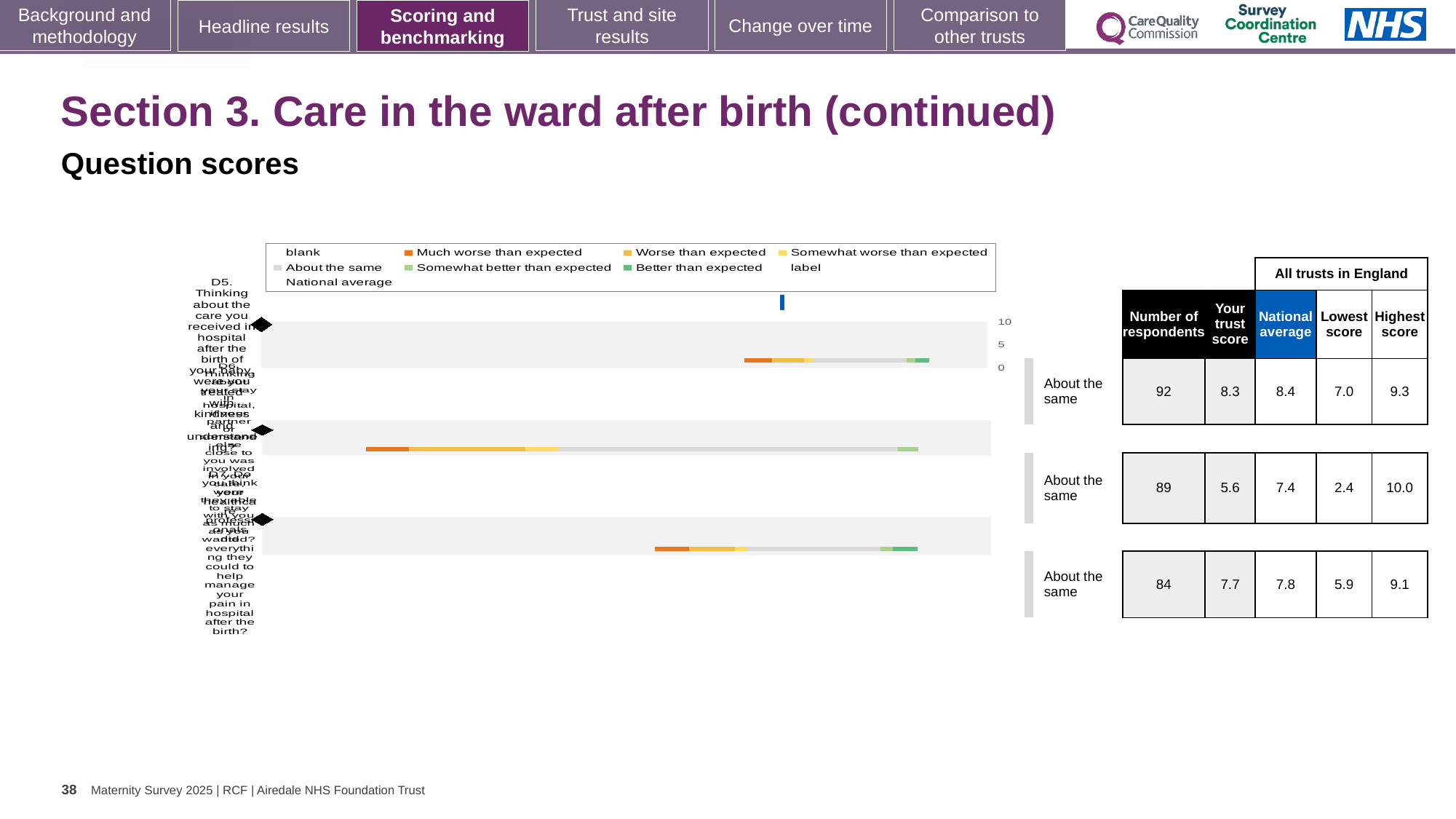
In the table beside the chart, what is 'Your trust score' for the second row? 5.6 In the table beside the chart, what is the difference between the national average and 'Your trust score' in the first row? 0.1 In the table beside the chart, what benchmark label is given for each of the three rows? About the same How many bars (question rows) are plotted in the chart? 3 In the table beside the chart, what is the number of respondents for the first row? 92 What is the highest tick value shown on the chart's axis? 10 In the table beside the chart, what is the national average for the third row? 7.8 In the table beside the chart, what is the lowest score for the second row? 2.4 What kind of chart is shown on the slide? bar chart How many entries does the chart's legend list? 9 In the table beside the chart, which is larger for the second row: 'Your trust score' or the national average? National average What colour does the legend use for 'Much worse than expected'? orange